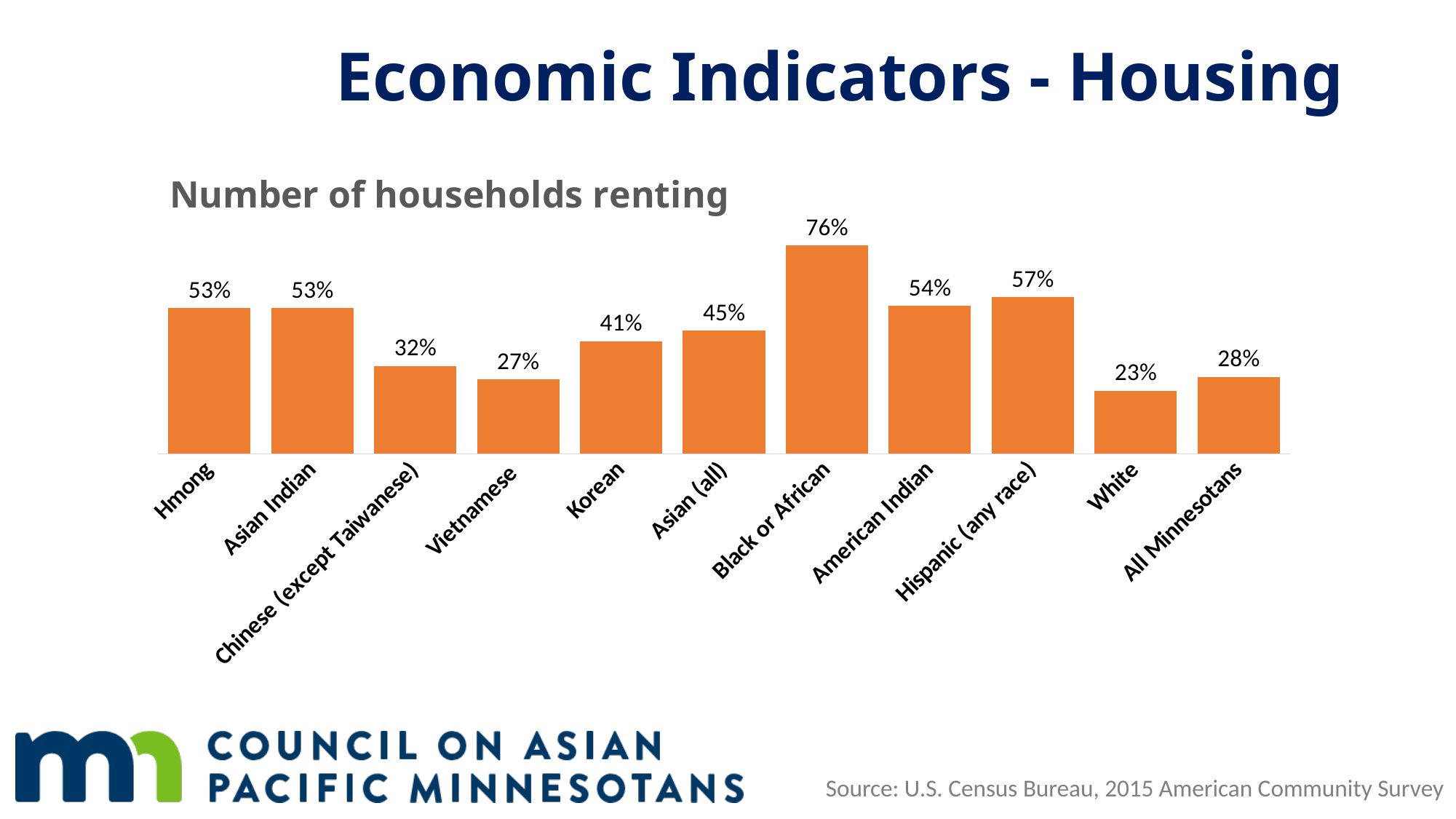
What is the title of the chart? Number of households renting How many categories are shown in the chart? 11 Which is larger, the value for American Indian or the value for Asian (all)? American Indian Which category has the highest value? Black or African What is the value for Hmong? 53% What is the value for Hispanic (any race)? 57% What kind of chart is shown on the slide? Bar chart What is the value for All Minnesotans? 28% What is the difference between the values for Black or African and White? 53% What is the value for Vietnamese? 27% What is the difference between the values for Korean and Chinese (except Taiwanese)? 9% Which category has the lowest value? White